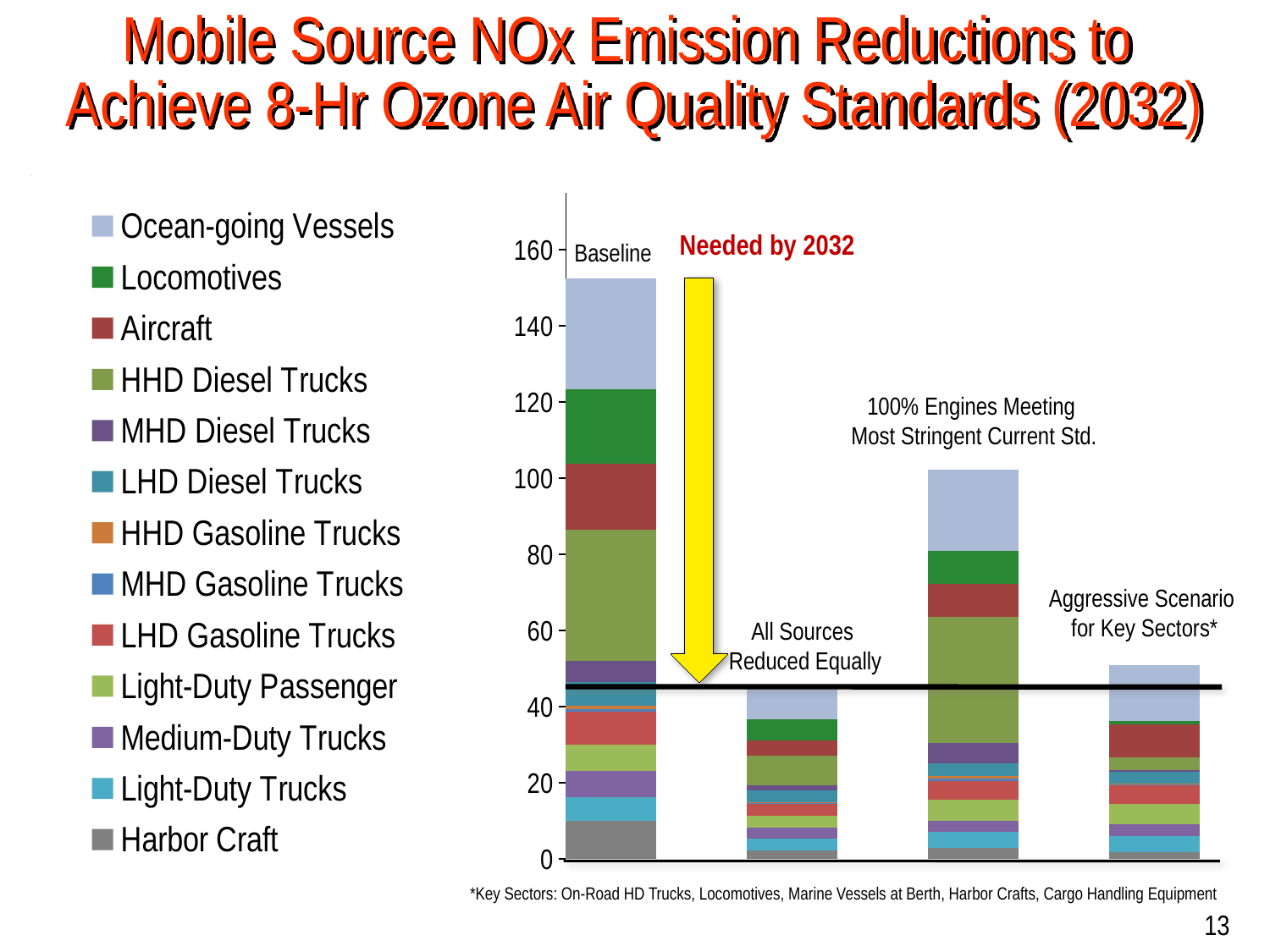
Is the total for the 100% Engines Meeting Most Stringent Current Std. bar greater or less than 100? greater Is the total for the Baseline bar greater or less than 140? greater How many series does the legend list? 13 Which legend entry is shown at the top of the legend? Ocean-going Vessels Which bar is taller: 100% Engines Meeting Most Stringent Current Std. or Aggressive Scenario for Key Sectors? 100% Engines Meeting Most Stringent Current Std. What label is written next to the yellow arrow in the chart? Needed by 2032 Which bar has the highest total? Baseline Is the total for the Aggressive Scenario for Key Sectors bar greater or less than 60? less Which bar has the lowest total? All Sources Reduced Equally What kind of chart is shown on the slide? stacked bar chart How many bars (scenarios) are plotted in the chart? 4